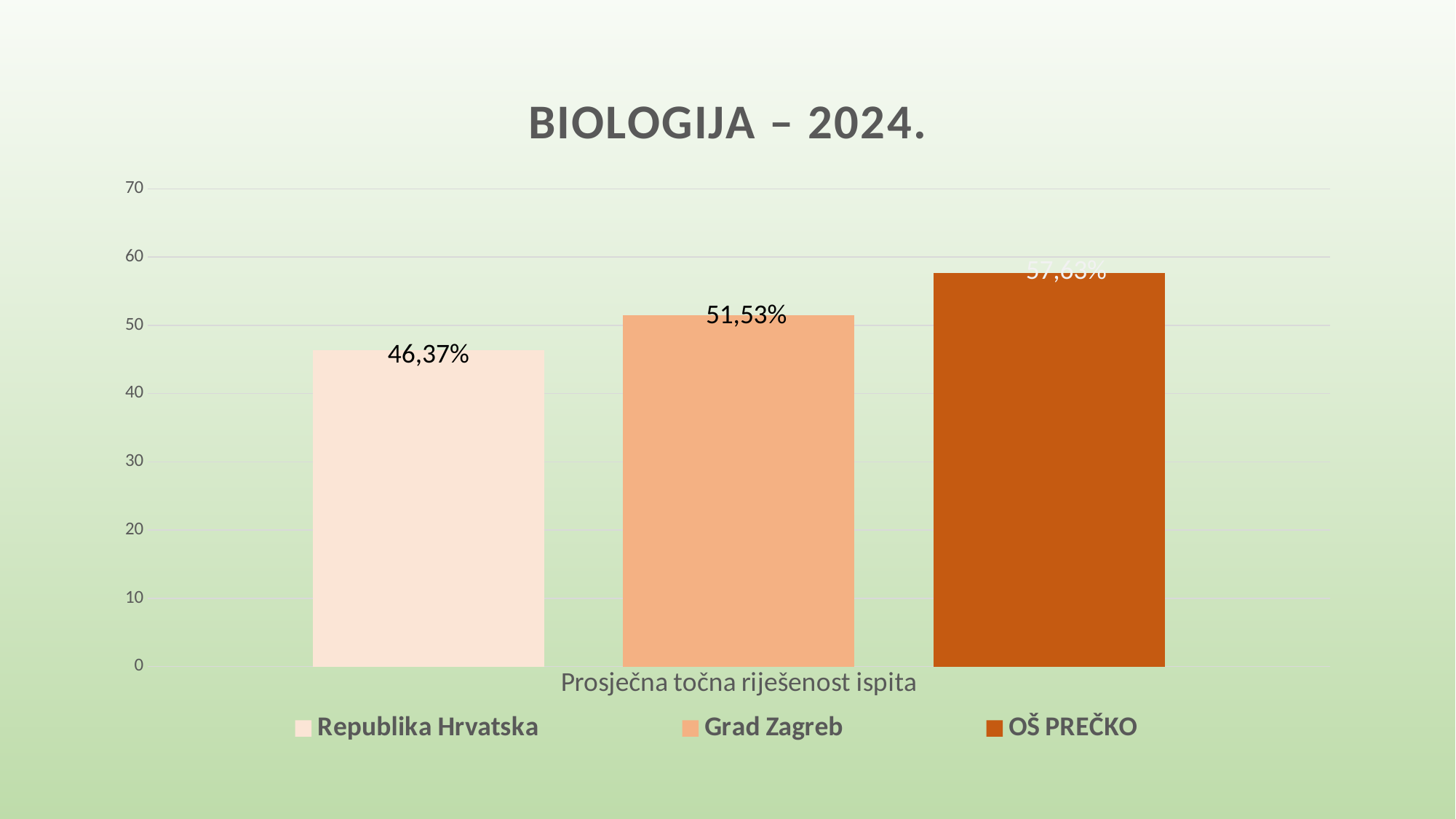
What is the title of the chart? BIOLOGIJA – 2024. What is the value for Republika Hrvatska? 46,37% What is the label shown on the x axis? Prosječna točna riješenost ispita What is the difference between the values for Grad Zagreb and Republika Hrvatska? 5,16% Is the value for OŠ PREČKO greater or less than 60? less Which series has the highest value? OŠ PREČKO What is the value for Grad Zagreb? 51,53% Is the value for OŠ PREČKO greater or less than 50? greater Which is larger, the value for Grad Zagreb or the value for Republika Hrvatska? Grad Zagreb What type of chart is shown on the slide? bar chart How many series does the legend list? 3 Which series has the lowest value? Republika Hrvatska